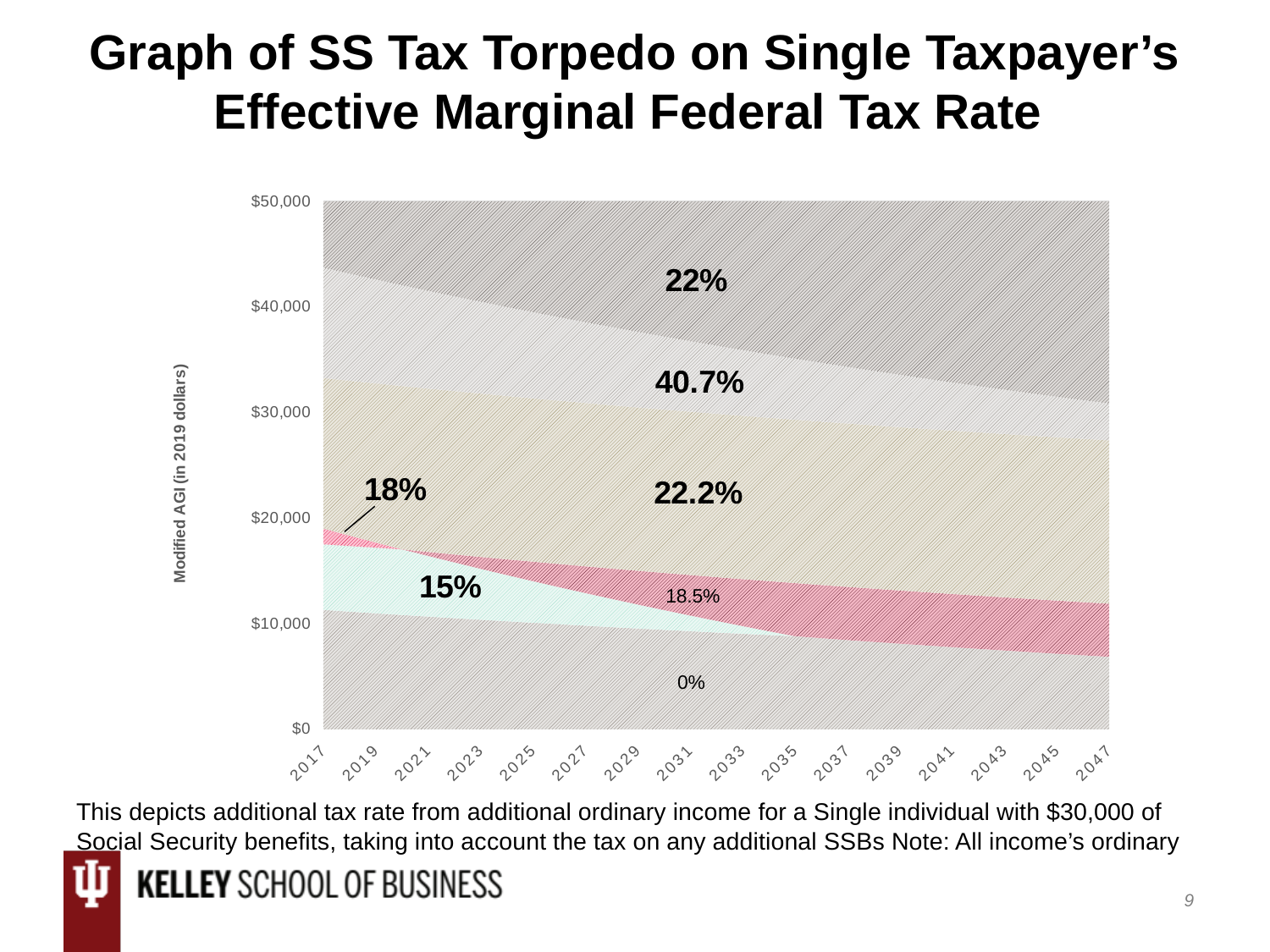
How many year ticks are shown along the x axis? 16 Which labeled rate is larger, 40.7% or 22.2%? 40.7% What is the lowest tax rate labeled on the chart? 0% What is the label on the vertical axis of the chart? Modified AGI (in 2019 dollars) Does the upper boundary of the 0% band rise or fall from 2017 to 2047? fall Which tax rate band lies between the 40.7% band and the 18.5% band? 22.2% Which tax rate is labeled in the bottom band of the chart? 0% What is the highest tax rate labeled on the chart? 40.7% Is the upper boundary of the 0% band in 2017 greater or less than $10,000? greater Which tax rate is labeled in the topmost band of the chart? 22% What is the title of the chart? Graph of SS Tax Torpedo on Single Taxpayer's Effective Marginal Federal Tax Rate What kind of chart is shown on the slide? Area chart